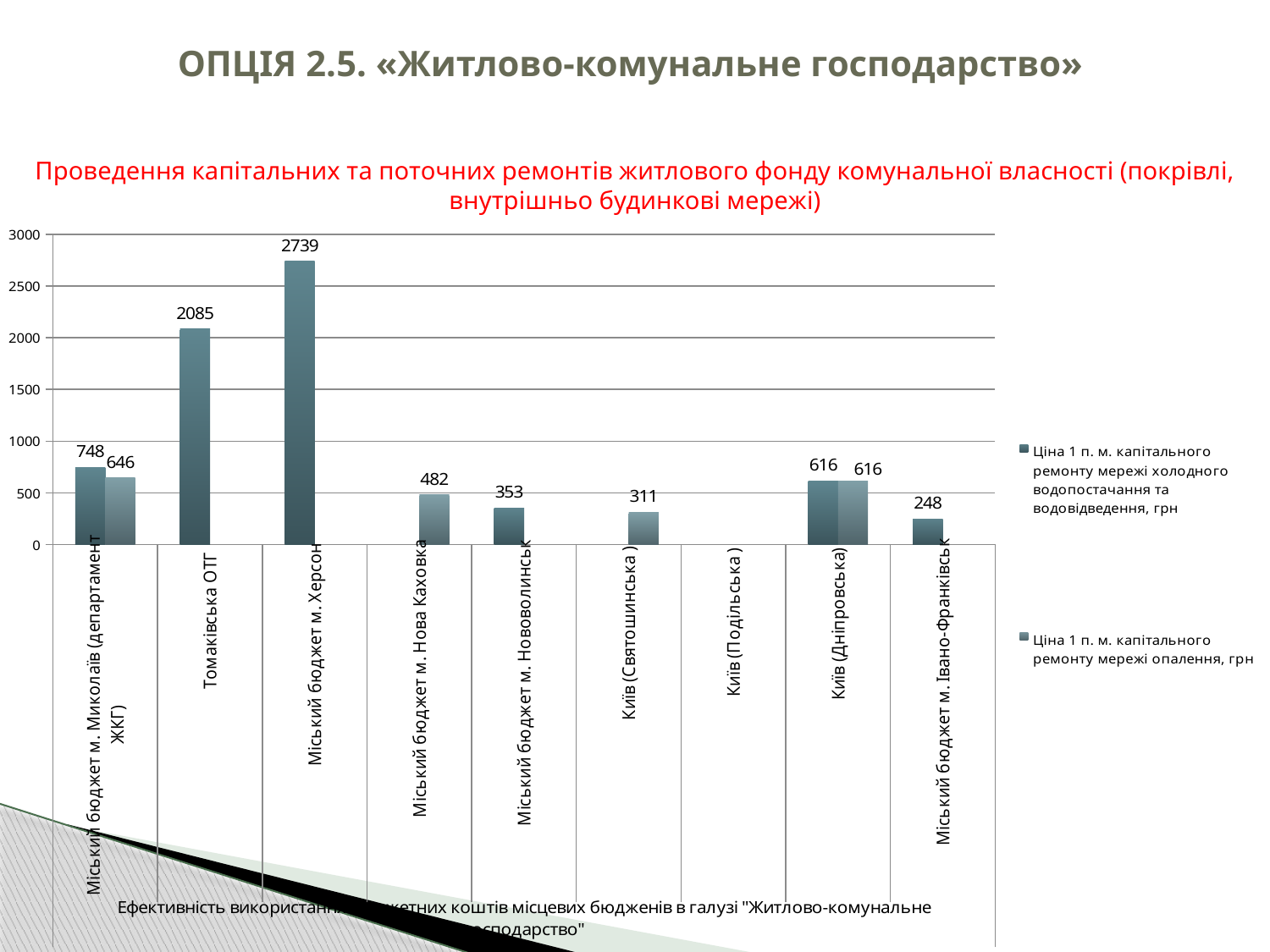
How many categories are shown on the x axis? 9 Which category has the highest value on the chart? Міський бюджет м. Херсон What is the value for Томаківська ОТГ? 2085 What is the value for Міський бюджет м. Херсон? 2739 What is the value for Міський бюджет м. Івано-Франківськ? 248 Is the value for Томаківська ОТГ greater or less than 2000? greater What kind of chart is shown on the slide? Bar chart For Міський бюджет м. Миколаїв, which series has the larger value: cold water supply or heating network? Cold water supply (748) What is the difference between the values for Міський бюджет м. Херсон and Томаківська ОТГ? 654 How many series does the legend list? 2 What is the value of the heating network series (Ціна 1 п. м. капітального ремонту мережі опалення) for Міський бюджет м. Миколаїв? 646 Which category has the lowest value for the cold water supply series (Ціна 1 п. м. капітального ремонту мережі холодного водопостачання та водовідведення)? Міський бюджет м. Івано-Франківськ